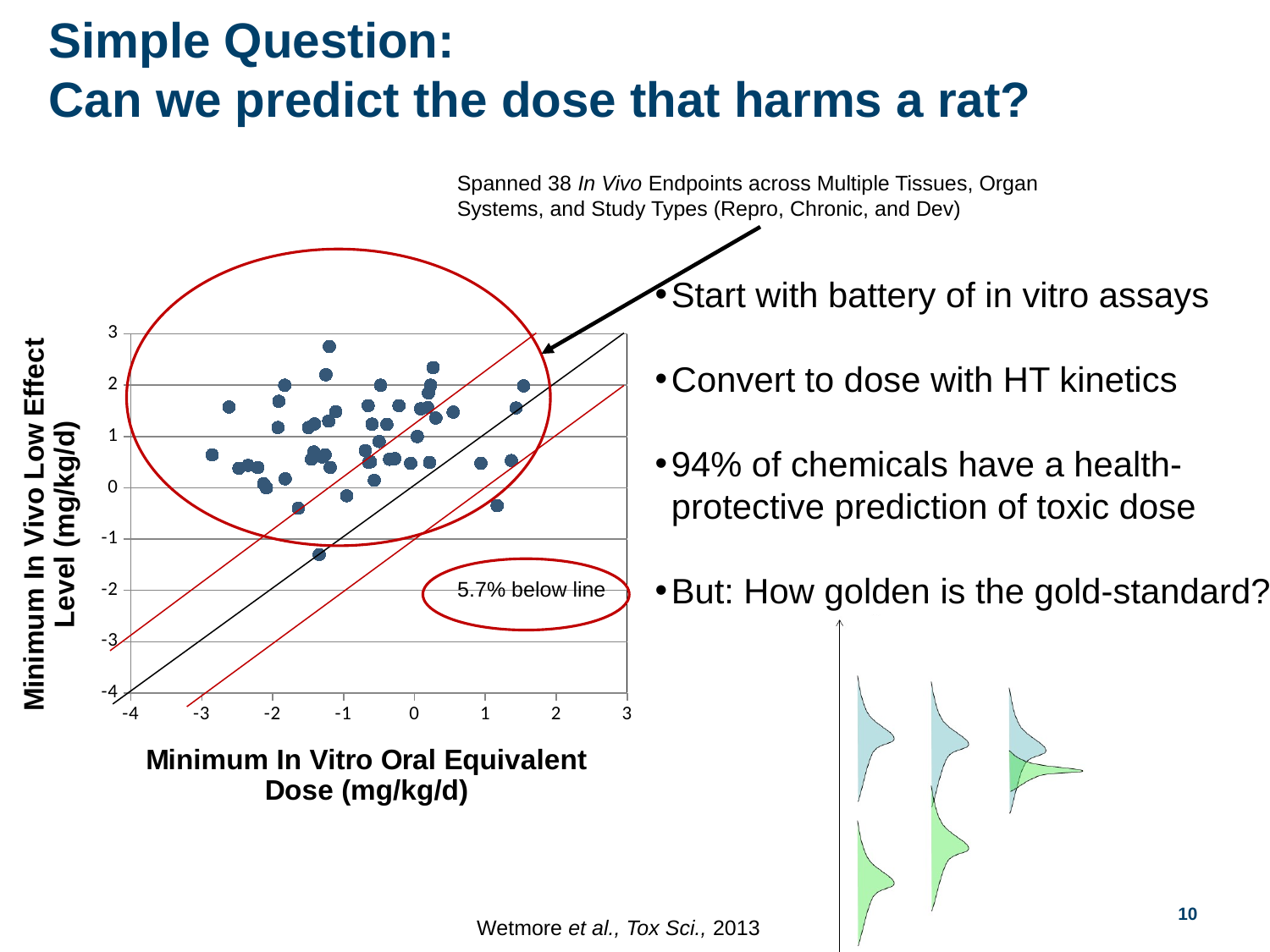
Is the y value of the highest point in the scatter plot greater or less than 3? less Is the x value of the rightmost point in the scatter plot greater or less than 2? less What is the lowest tick value shown on the x axis of the scatter plot? -4 What text is written inside the small red oval in the lower right of the plot area? 5.7% below line Is the y value of the lowest point in the scatter plot greater or less than -1? less What is the highest tick value shown on the y axis of the scatter plot? 3 What kind of chart is shown on the slide? scatter plot What is the title of the x axis of the scatter plot? Minimum In Vitro Oral Equivalent Dose (mg/kg/d)